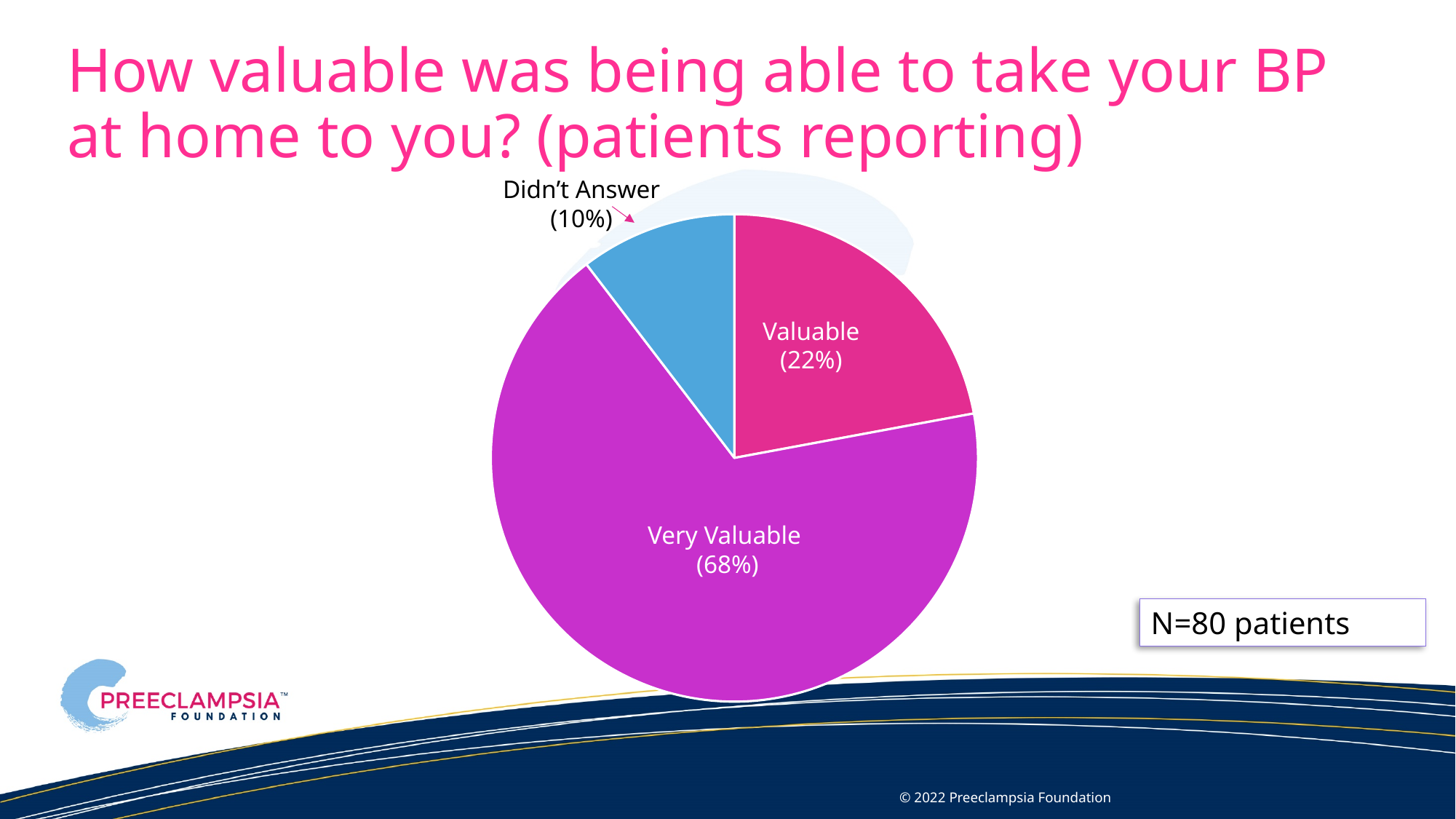
Which response category has the smallest slice of the pie? Didn't Answer Which is larger, the Valuable slice or the Didn't Answer slice? Valuable Which response category has the largest slice of the pie? Very Valuable What is the difference in percentage points between the Valuable and Didn't Answer slices? 12 What share of patients reported that taking their BP at home was Very Valuable? 68% What colour is the Didn't Answer slice? Blue How many patients are reported in the sample (N) on the slide? 80 How many slices does the pie chart have? 3 What share of patients Didn't Answer? 10% What share of patients reported that taking their BP at home was Valuable? 22% What is the difference in percentage points between the Very Valuable and Valuable slices? 46 What kind of chart is shown on the slide? Pie chart